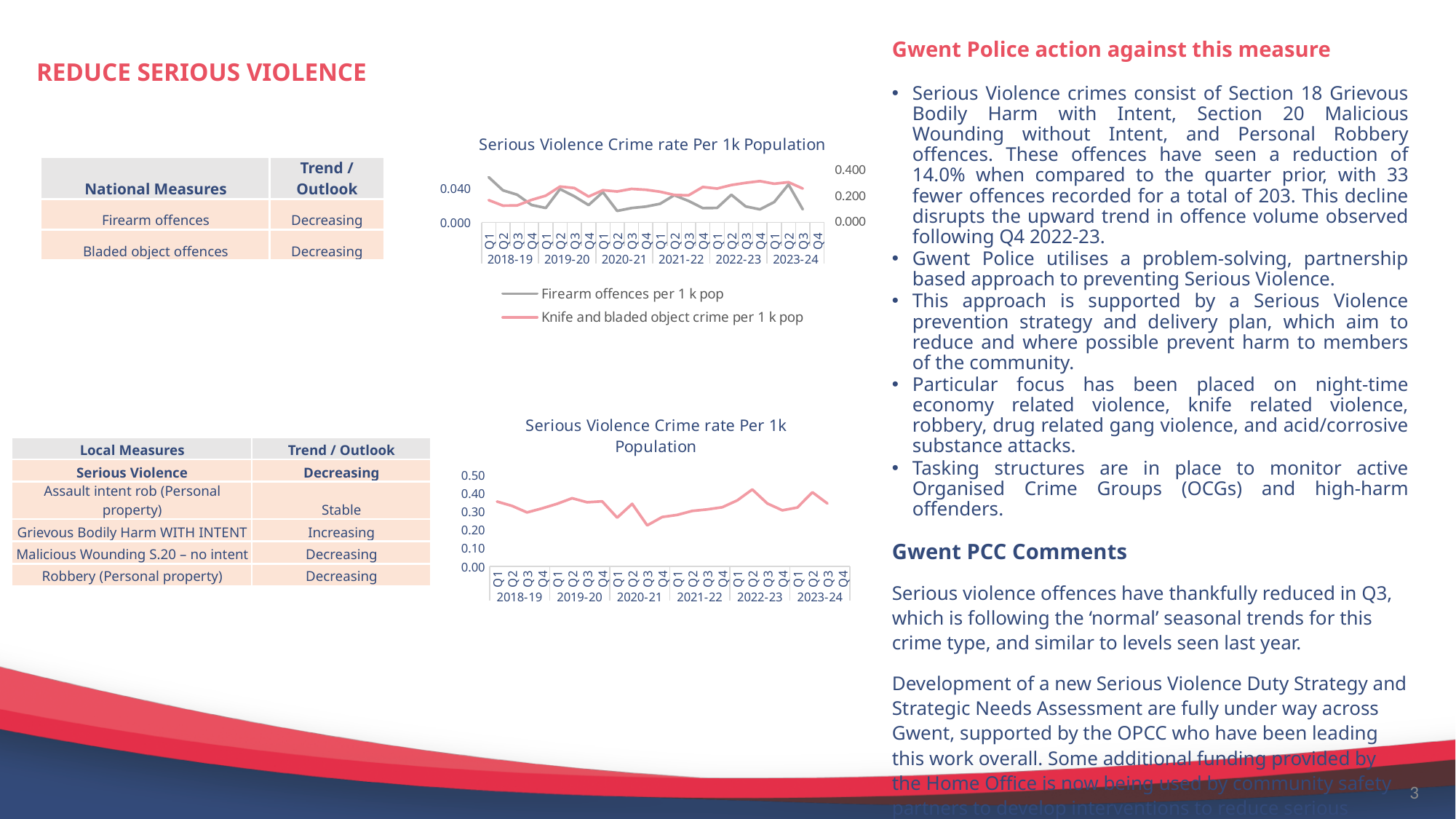
What kind of chart is the bottom chart titled 'Serious Violence Crime rate Per 1k Population'? Line chart In the top chart, what are the two series named in the legend? Firearm offences per 1 k pop; Knife and bladed object crime per 1 k pop In the bottom chart, is the value for Q3 2020-21 greater or less than 0.30? less In the top chart, what colour is the line for Knife and bladed object crime per 1 k pop? Pink How many financial years are shown on the x axis of the top chart? 6 In the bottom chart, which quarter has the lowest value? Q3 2020-21 In the bottom chart, which quarter has the highest value? Q2 2022-23 In the bottom chart, which is larger: the value for Q2 2022-23 or the value for Q3 2020-21? Q2 2022-23 What kind of chart is the top chart titled 'Serious Violence Crime rate Per 1k Population'? Line chart In the bottom chart, is the value for Q2 2022-23 greater or less than 0.40? greater In the bottom chart, is the value for Q1 2018-19 greater or less than 0.30? greater How many series does the legend of the top chart list? 2